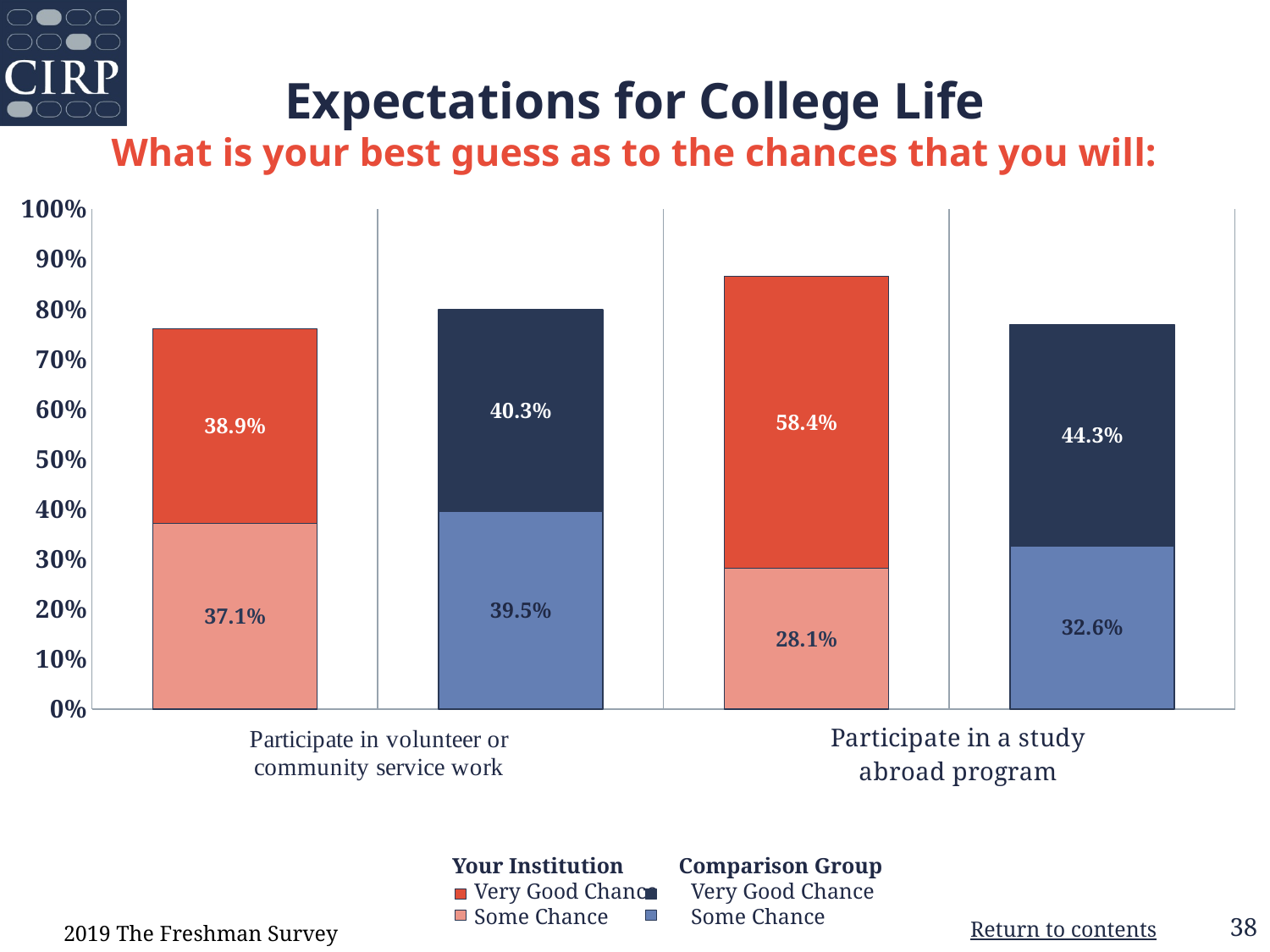
What is the subtitle question shown in red above the chart? What is your best guess as to the chances that you will: What is the Some Chance value for the Comparison Group for participating in a study abroad program? 32.6% What is the difference between the Very Good Chance values for Your Institution and the Comparison Group for the study abroad program? 14.1% What is the Some Chance value for the Comparison Group for participating in volunteer or community service work? 39.5% Which of the four stacked bars has the lowest Some Chance value? Your Institution, study abroad program (28.1%) How many series does the legend list? 4 Which Very Good Chance value is larger for the study abroad program: Your Institution or the Comparison Group? Your Institution What is the total height of the Your Institution stacked bar for participating in a study abroad program? 86.5% What is the total height of the Comparison Group stacked bar for participating in volunteer or community service work? 79.8% What is the Very Good Chance value for Your Institution for participating in a study abroad program? 58.4% What percentage of Your Institution students said there is a Very Good Chance they will participate in volunteer or community service work? 38.9% What type of chart is shown on the slide? Stacked bar chart